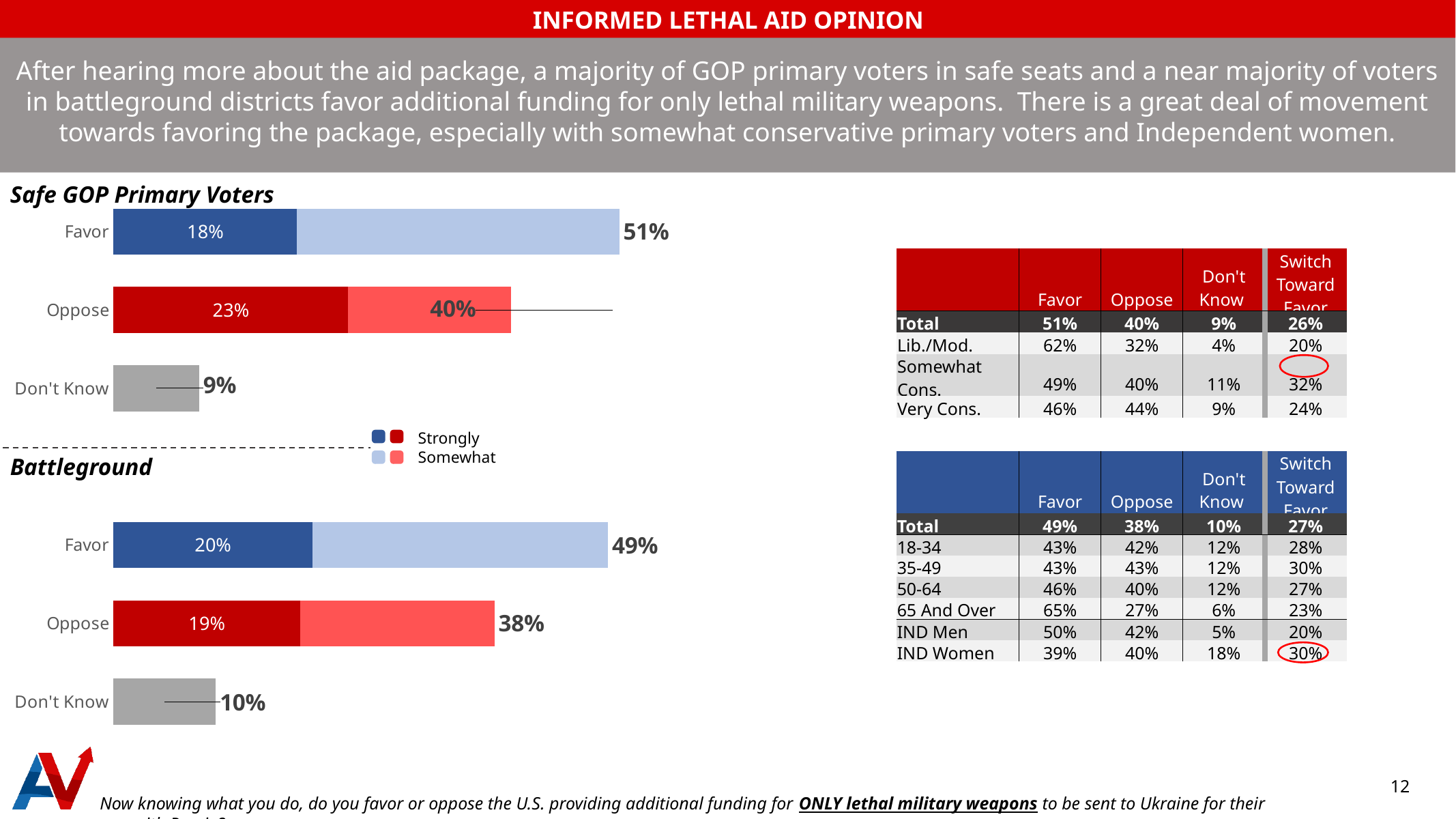
What kind of chart is the Battleground chart? Stacked bar chart In the Safe GOP Primary Voters chart, what is the Don't Know value? 9% In the Safe GOP Primary Voters chart, which category has the lowest total value? Don't Know In the Battleground chart, which category has the highest total value? Favor In the Battleground chart, which is larger, the Strongly Favor value or the Strongly Oppose value? Strongly Favor In the Safe GOP Primary Voters chart, what is the total Favor value? 51% In the Battleground chart, what is the Strongly Favor value? 20% In the Safe GOP Primary Voters chart, what is the Strongly Oppose value? 23% In the Battleground chart, what is the total Oppose value? 38% In the Safe GOP Primary Voters chart, what is the difference between the total Favor and total Oppose values? 11% In the Battleground chart, what is the Don't Know value? 10% How many series does the legend list for the bar charts? 2